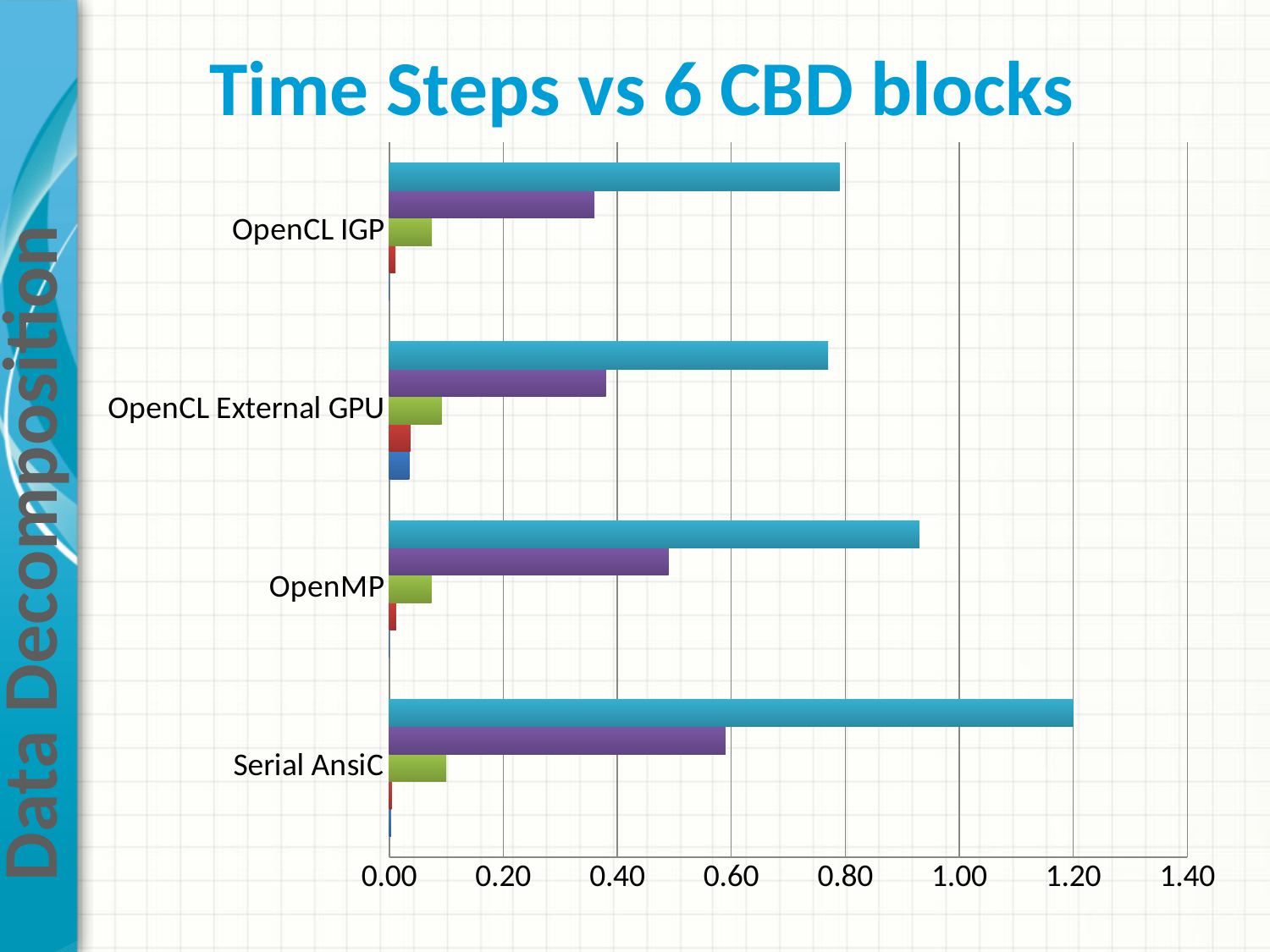
Is the teal bar for Serial AnsiC greater or less than 1.00? greater What kind of chart is shown on the slide? bar chart Which category has the longest teal (light blue) bar? Serial AnsiC Is the teal bar for OpenMP greater or less than 0.80? greater What is the title of the chart? Time Steps vs 6 CBD blocks Which is larger: the teal bar for OpenMP or the teal bar for OpenCL IGP? OpenMP Is the purple bar for OpenMP greater or less than 0.40? greater Which is larger: the teal bar for Serial AnsiC or the teal bar for OpenMP? Serial AnsiC What is the highest value shown on the horizontal axis? 1.40 How many categories are shown on the vertical axis of the chart? 4